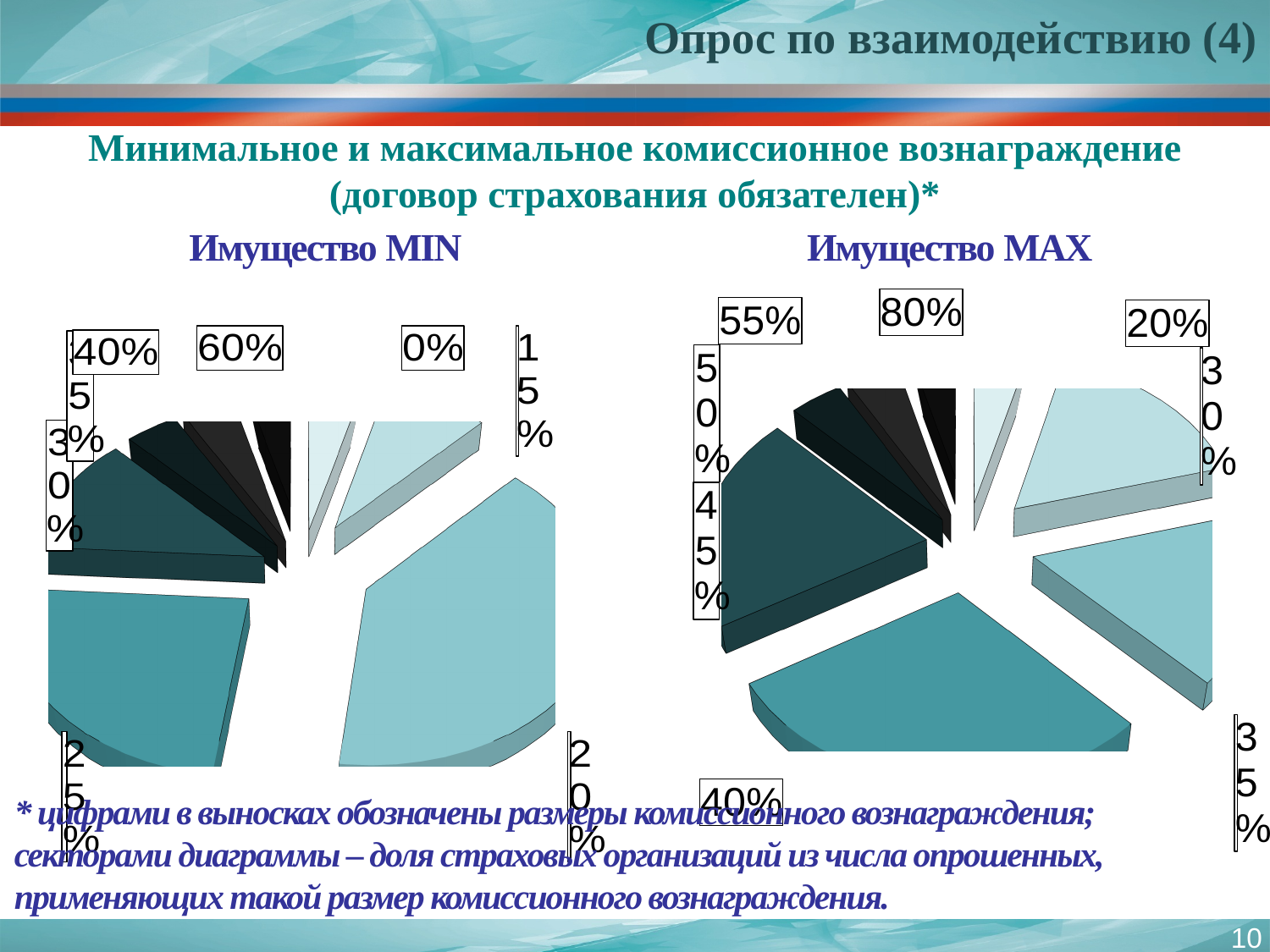
How many labelled sectors does the "Имущество MIN" chart on the left have? 8 How many labelled sectors does the "Имущество MAX" chart on the right have? 8 What kind of chart is the "Имущество MIN" chart on the left? pie chart What kind of chart is the "Имущество MAX" chart on the right? pie chart What is the highest commission-rate label shown on the "Имущество MIN" chart on the left? 60% In the "Имущество MAX" chart on the right, which commission-rate label is attached to the largest sector? 40% What is the lowest commission-rate label shown on the "Имущество MIN" chart on the left? 0% What is the lowest commission-rate label shown on the "Имущество MAX" chart on the right? 20% What is the title of the pie chart on the left? Имущество MIN What is the title of the pie chart on the right? Имущество MAX What is the highest commission-rate label shown on the "Имущество MAX" chart on the right? 80%